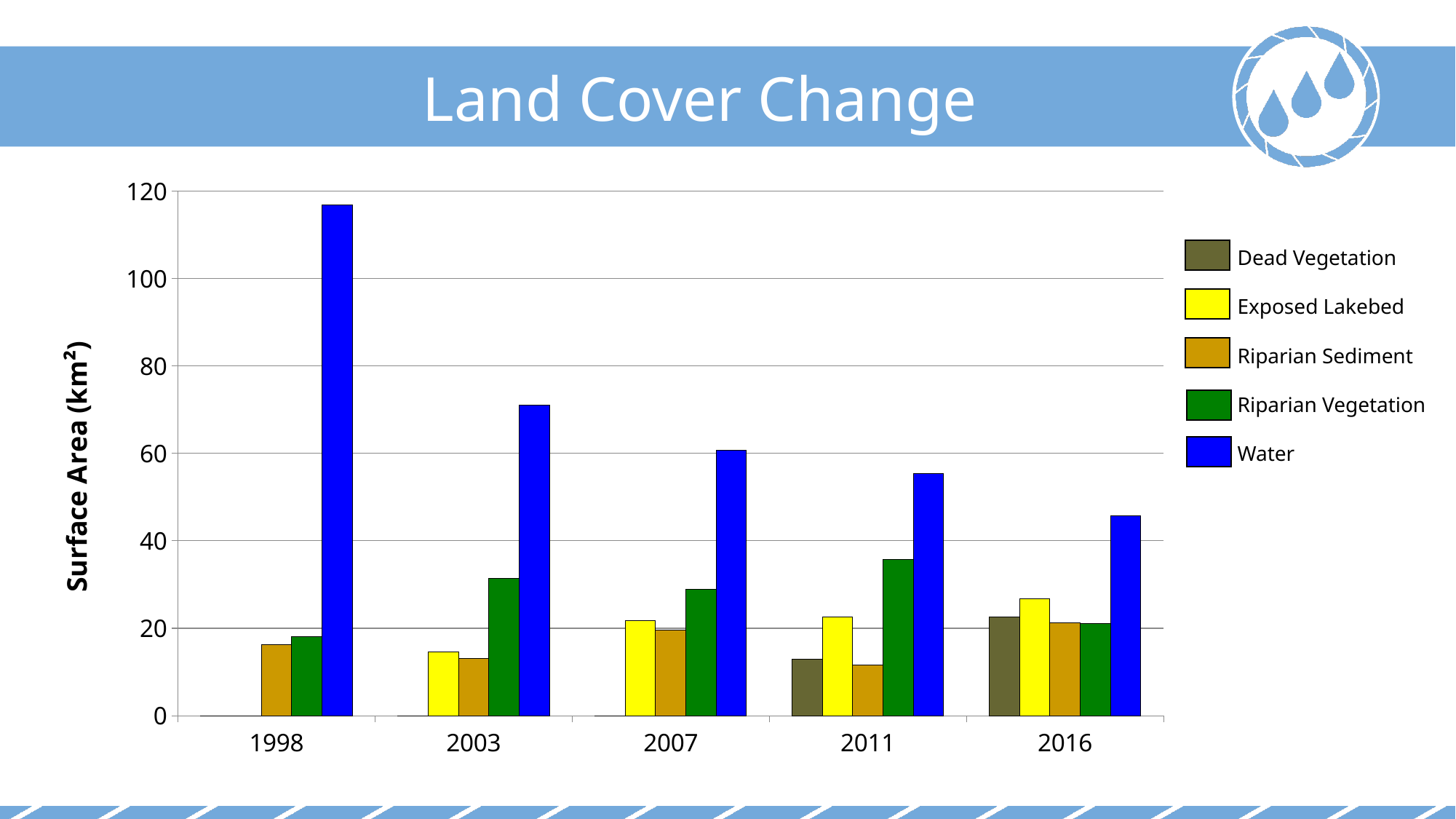
Does the Water surface area rise or fall from 1998 to 2016? fall Which series has the highest value in 2016? Water Is the value for Water in 1998 greater or less than 100? greater In which year is the Water surface area highest? 1998 How many series does the legend list? 5 Is the value for Exposed Lakebed in 2003 greater or less than 20? less What is the label of the y axis? Surface Area (km²) What kind of chart is shown on the slide? bar chart Is the value for Water in 2016 greater or less than 60? less How many years are shown along the x axis? 5 In which year is the Water surface area lowest? 2016